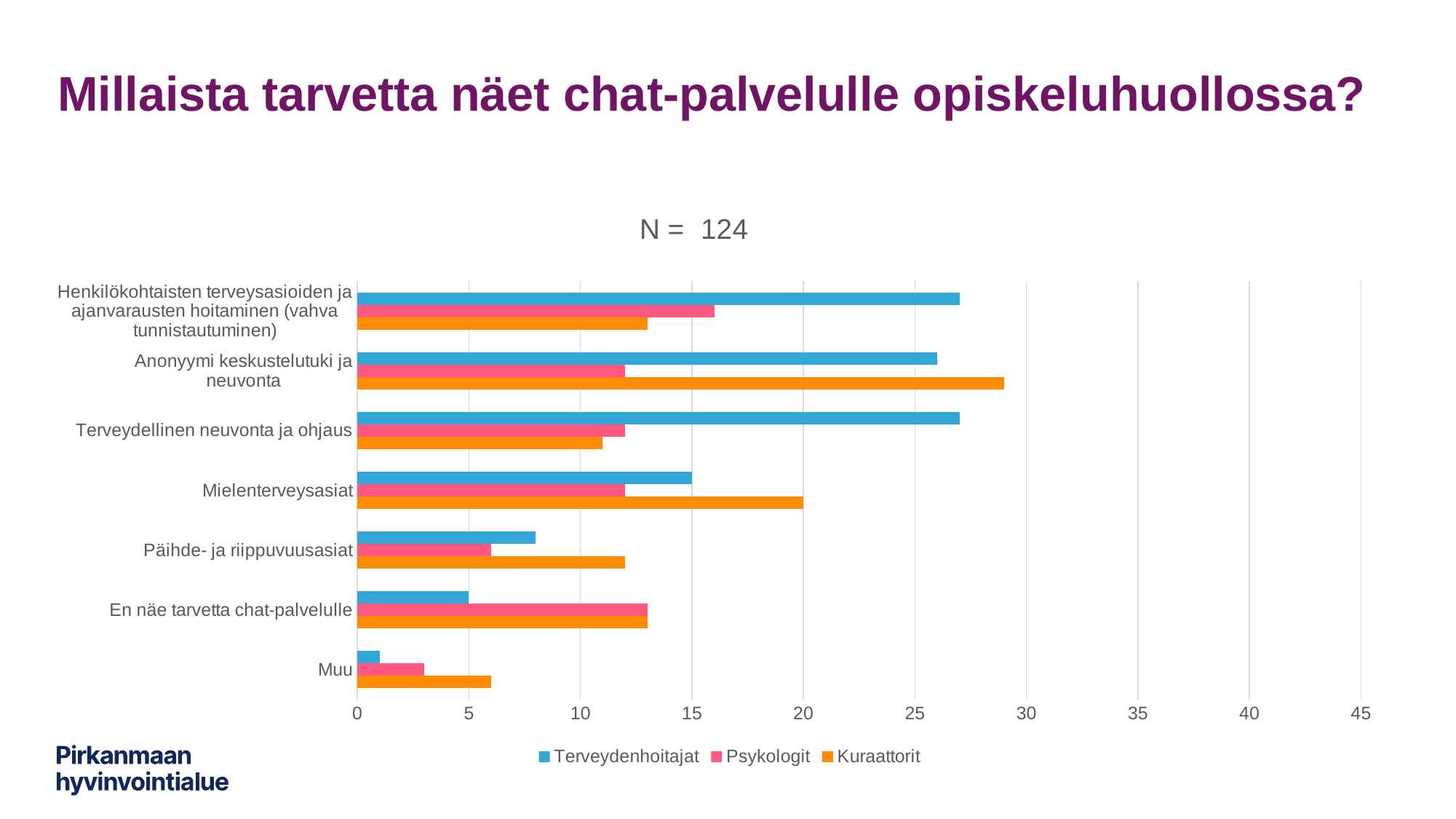
Is the Kuraattorit value for Anonyymi keskustelutuki ja neuvonta greater or less than 25? greater How many categories are shown on the vertical axis of the chart? 7 How many series does the legend list? 3 Is the Psykologit value for Henkilökohtaisten terveysasioiden ja ajanvarausten hoitaminen greater or less than 20? less For which category is the Kuraattorit bar the longest? Anonyymi keskustelutuki ja neuvonta For which category is the Terveydenhoitajat bar the shortest? Muu What is the value of N shown above the chart? 124 For En näe tarvetta chat-palvelulle, which series has the larger value: Psykologit or Terveydenhoitajat? Psykologit For Mielenterveysasiat, which series has the larger value: Kuraattorit or Terveydenhoitajat? Kuraattorit Which colour represents the Kuraattorit series in the legend? orange What kind of chart is shown on the slide? bar chart Is the Terveydenhoitajat value for Päihde- ja riippuvuusasiat greater or less than 10? less